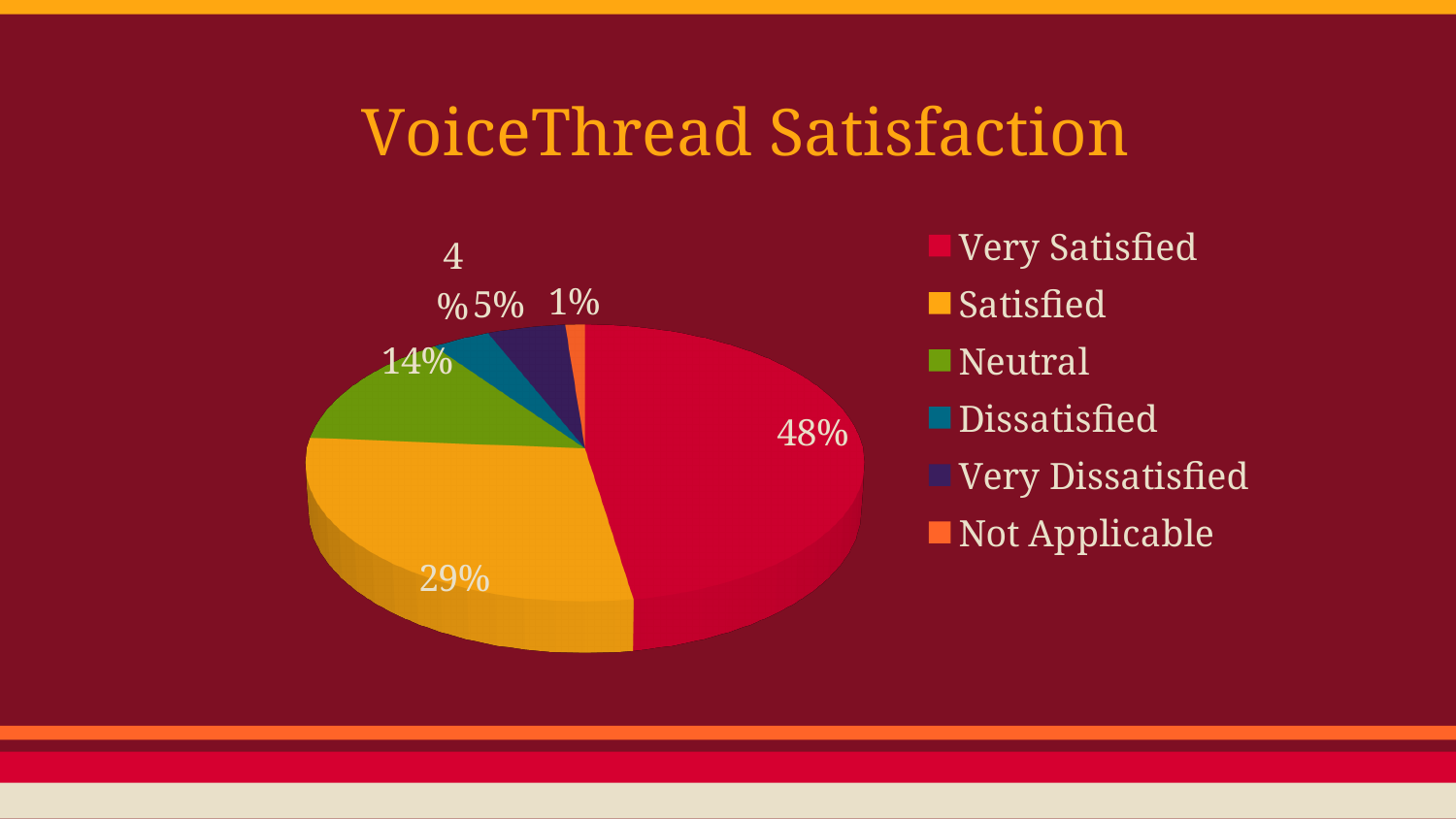
What percentage of respondents were Neutral? 14% What is the difference in percentage points between Very Satisfied and Satisfied? 19 Which category has the smallest share of the pie? Not Applicable What percentage of respondents were Satisfied? 29% What percentage of respondents were Very Satisfied? 48% What colour is the Neutral slice? green How many categories does the legend list? 6 What percentage of respondents answered Not Applicable? 1% Which category has the largest share of the pie? Very Satisfied What is the title of the chart? VoiceThread Satisfaction What type of chart is shown on the slide? pie chart Which is larger, the Neutral share or the Satisfied share? Satisfied